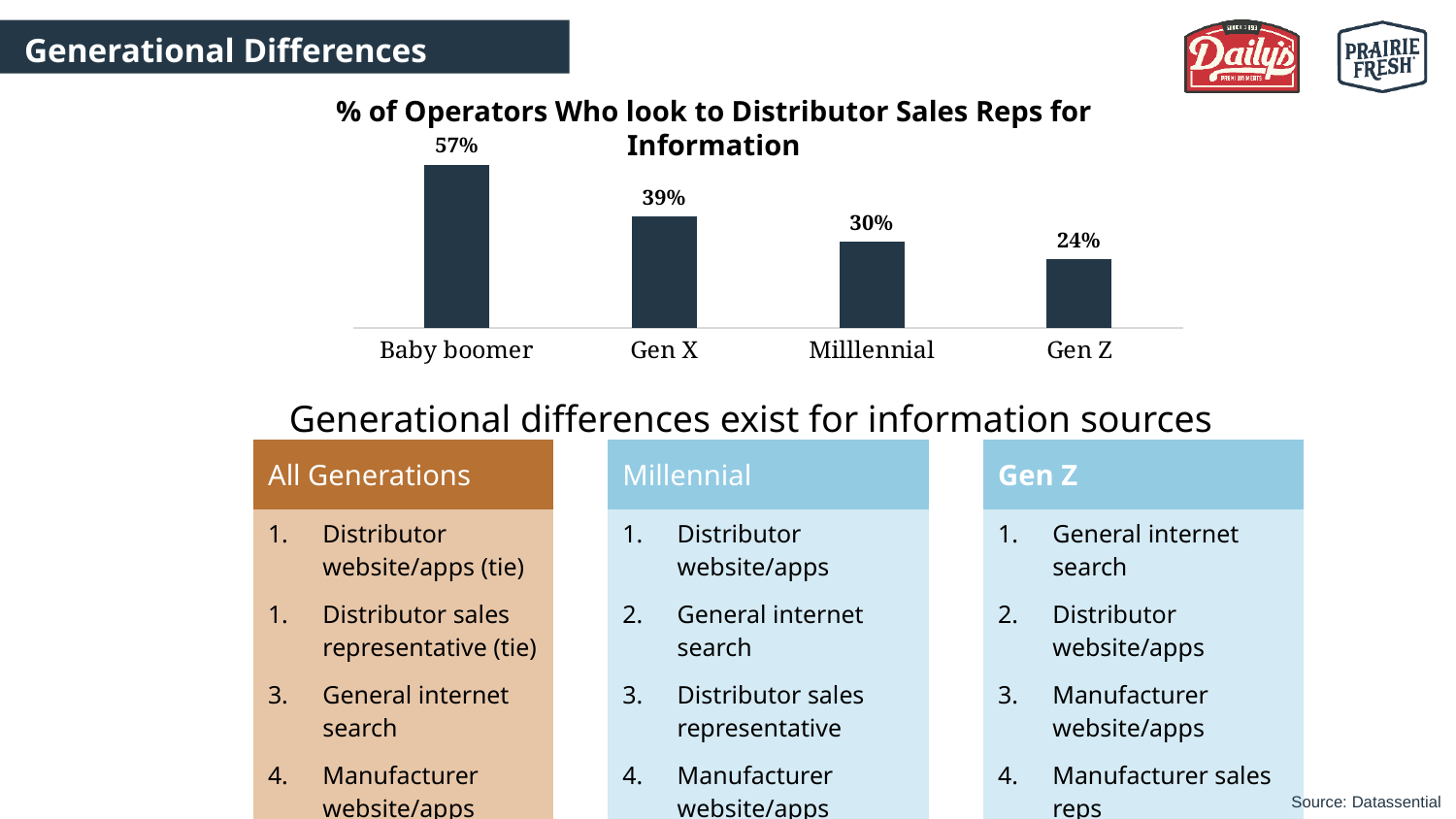
What is the value shown for Gen Z in the chart? 24% What type of chart is used on the slide? Bar chart What is the value shown for Millennial operators? 30% What is the value shown for Gen X in the chart? 39% Which generation has the lowest percentage in the chart? Gen Z Do the values rise or fall moving from Baby boomer to Gen Z along the x axis? Fall What is the difference between the Gen X and Millennial values? 9 percentage points What is the difference in percentage points between Baby boomer and Gen Z? 33 percentage points Which is larger, the value for Gen X or the value for Millennial? Gen X What percentage of Baby boomer operators look to distributor sales reps for information? 57% Which generation has the highest percentage of operators who look to distributor sales reps for information? Baby boomer How many generations are shown in the chart? 4